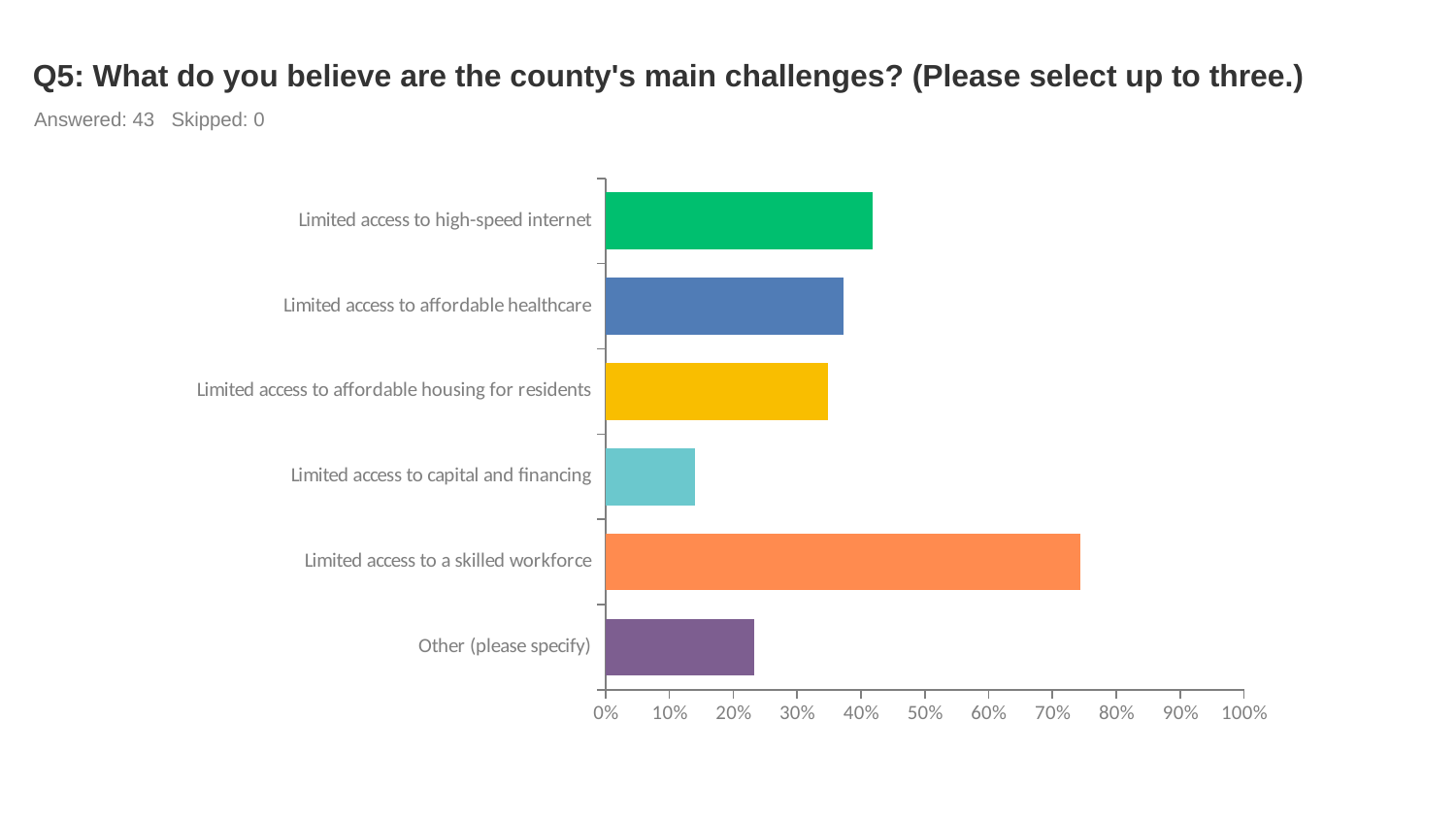
Is the value for Limited access to high-speed internet greater or less than 30%? greater Which challenge has the highest percentage in the chart? Limited access to a skilled workforce How many categories (challenges) are plotted in the chart? 6 Which challenge has the lowest percentage in the chart? Limited access to capital and financing Which is larger: the value for Limited access to affordable healthcare or the value for Other (please specify)? Limited access to affordable healthcare Is the value for Limited access to a skilled workforce greater or less than 70%? greater What kind of chart is shown on the slide? bar chart Is the value for Limited access to capital and financing greater or less than 20%? less Which is larger: the value for Limited access to a skilled workforce or the value for Limited access to high-speed internet? Limited access to a skilled workforce How many respondents answered the question shown on the slide? 43